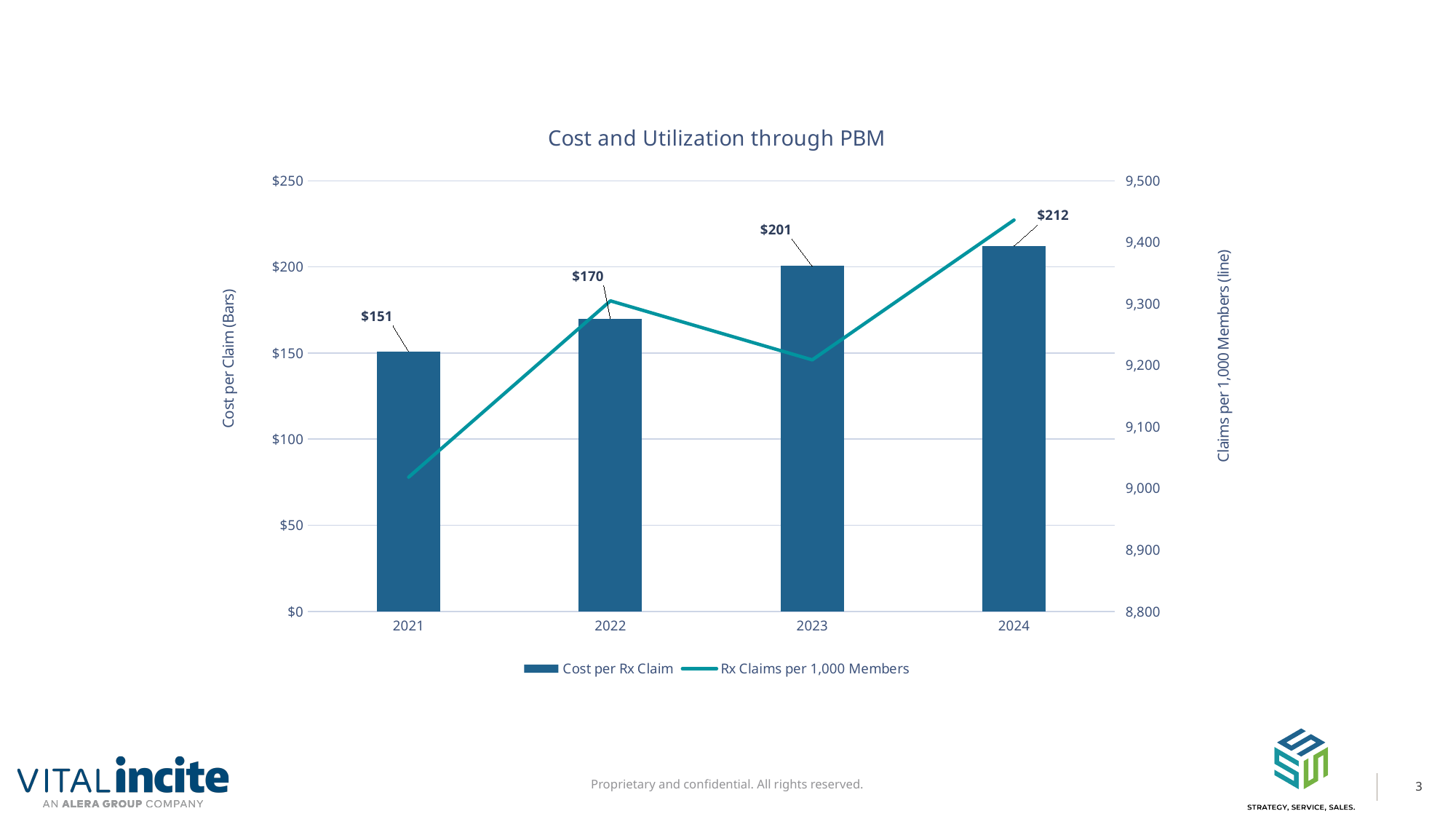
Is the value of Rx Claims per 1,000 Members for 2021 greater or less than 9,100? less Which year has a higher Cost per Rx Claim, 2022 or 2023? 2023 How many series does the legend list? 2 Which year has the lowest Cost per Rx Claim? 2021 Does the Cost per Rx Claim rise or fall from 2021 to 2024? rise Is the value of Rx Claims per 1,000 Members for 2024 greater or less than 9,400? greater What is the Cost per Rx Claim for 2023? $201 What is the Cost per Rx Claim for 2021? $151 What is the difference in Cost per Rx Claim between 2024 and 2021? $61 Is the value of Rx Claims per 1,000 Members for 2023 greater or less than 9,300? less How many years are shown on the x axis? 4 Which year has the highest Cost per Rx Claim? 2024